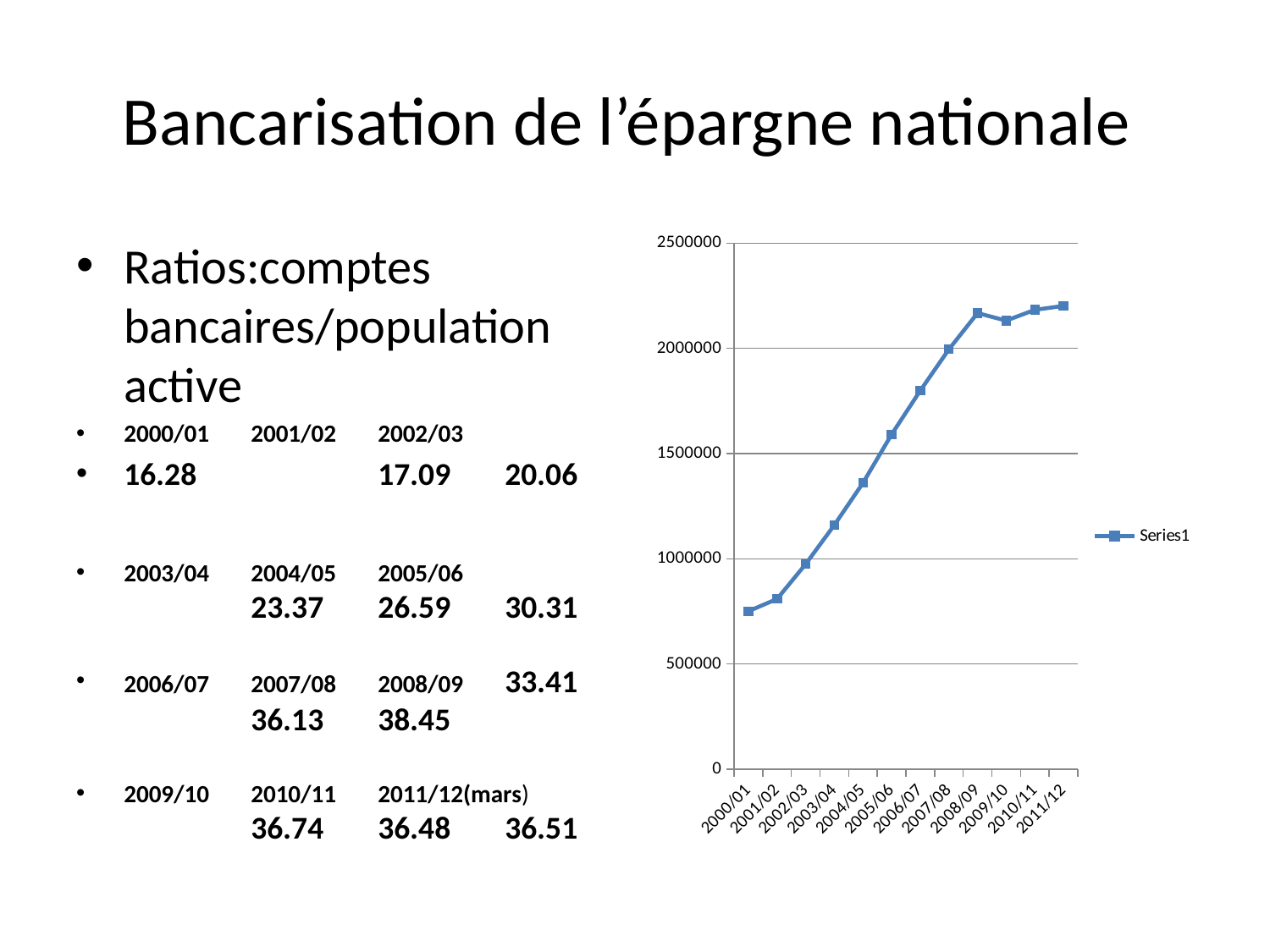
How many series does the chart's legend list? 1 Is the value for 2006/07 greater or less than 2000000? less Do the values in the chart generally rise or fall from 2000/01 to 2011/12? rise Which has the larger value in the chart, 2002/03 or 2006/07? 2006/07 How many data points are plotted along the x axis of the chart? 12 Is the value for 2003/04 greater or less than 1500000? less What is the name of the series shown in the chart's legend? Series1 Is the value for 2004/05 greater or less than 1000000? greater Which period has the lowest value in the chart? 2000/01 What kind of chart is shown on the slide? line chart